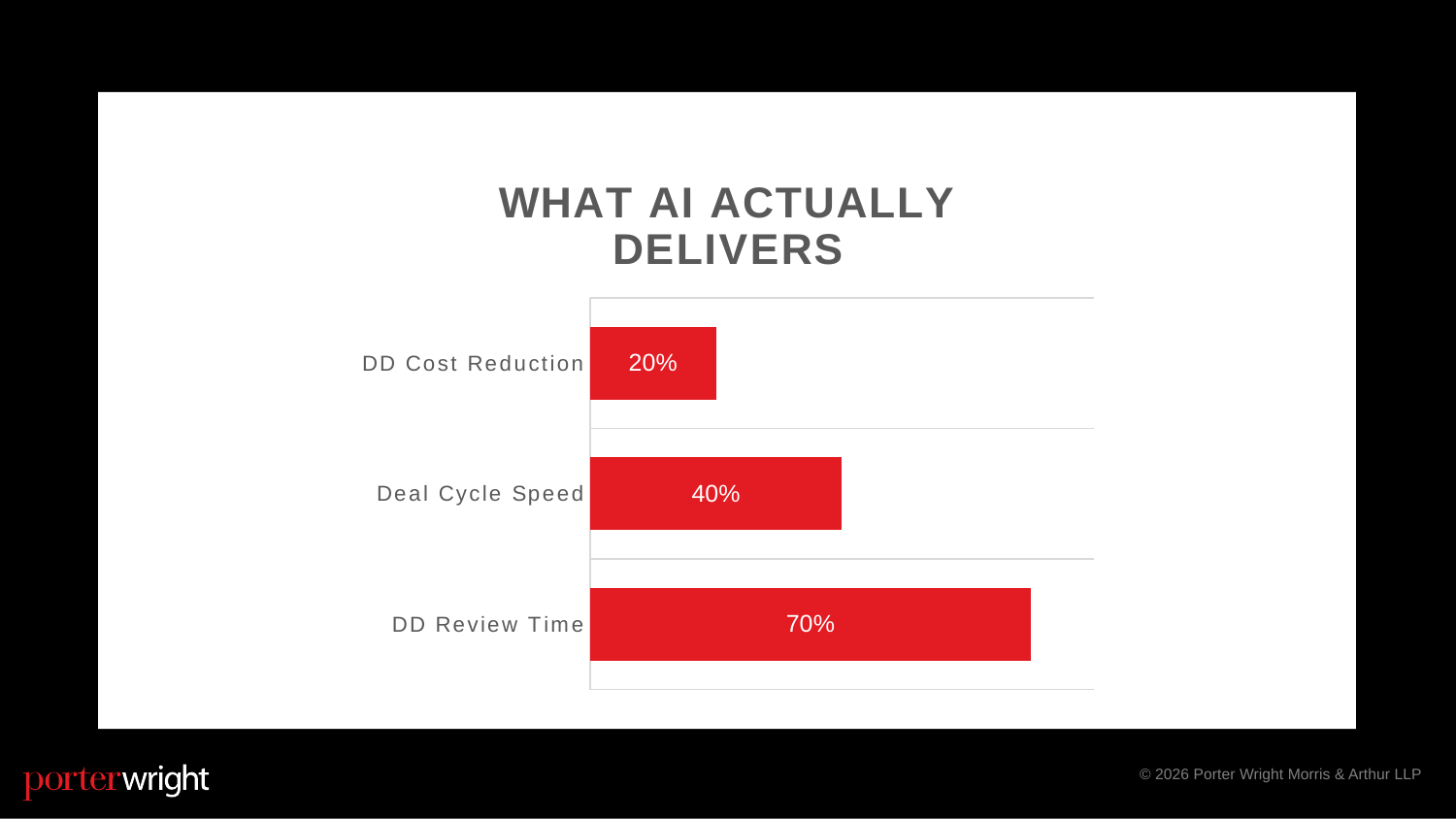
What is the value for DD Review Time? 70% What is the title of the chart? WHAT AI ACTUALLY DELIVERS What colour are the bars in the chart? Red How many categories are shown in the chart? 3 What is the value for DD Cost Reduction? 20% What is the value for Deal Cycle Speed? 40% What is the difference between the values for DD Review Time and Deal Cycle Speed? 30% What kind of chart is shown on the slide? Bar chart What is the difference between the values for Deal Cycle Speed and DD Cost Reduction? 20% Which category has the highest value? DD Review Time Which is larger, the value for Deal Cycle Speed or the value for DD Cost Reduction? Deal Cycle Speed Which category has the lowest value? DD Cost Reduction